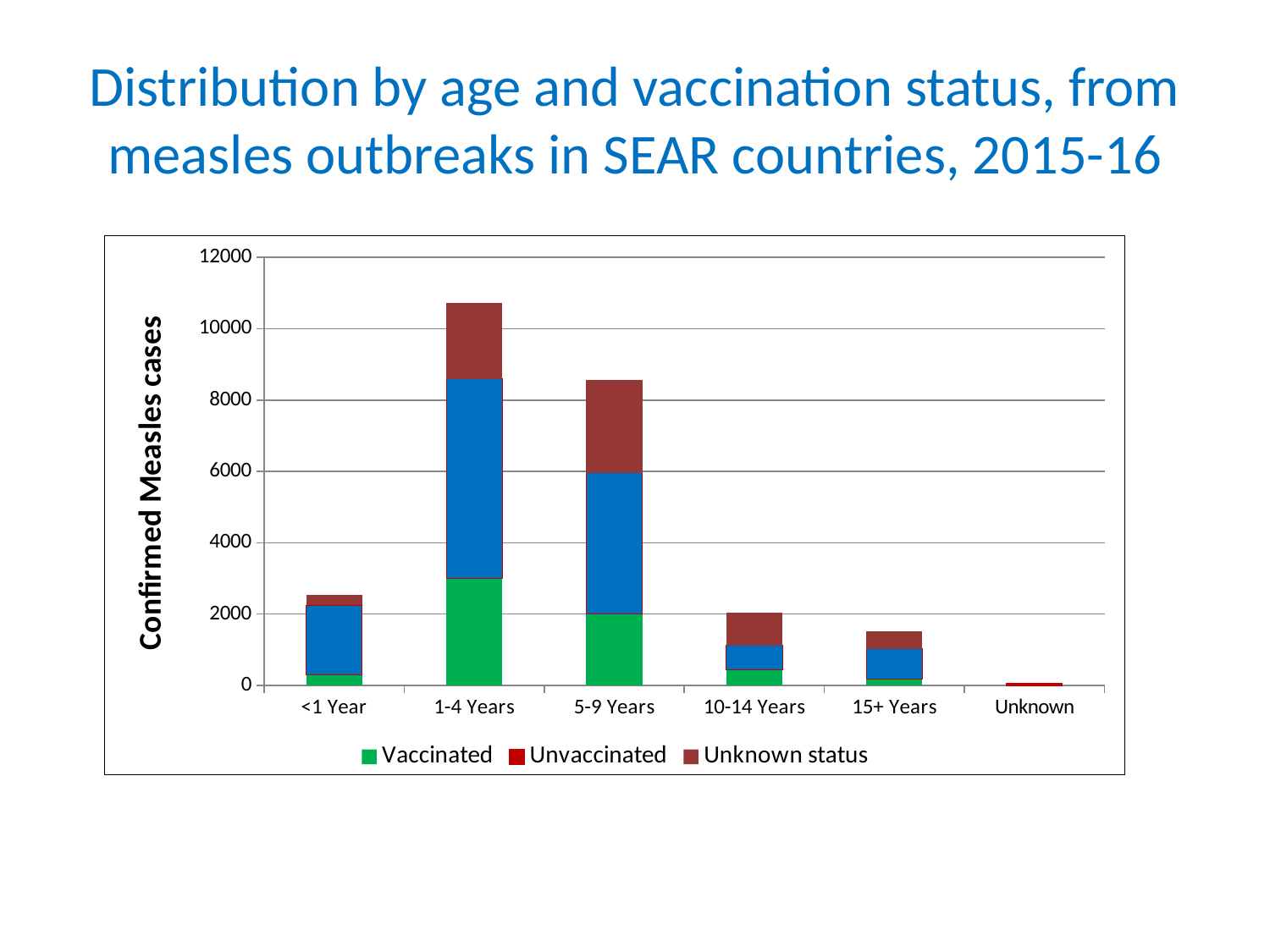
Which age group has more total confirmed measles cases, <1 Year or 15+ Years? <1 Year Is the total number of confirmed measles cases for 5-9 Years greater or less than 8000? greater Is the total number of confirmed measles cases for 15+ Years greater or less than 2000? less Is the total number of confirmed measles cases for 1-4 Years greater or less than 10000? greater Which age group has the highest total number of confirmed measles cases? 1-4 Years Which age group has more total confirmed measles cases, 1-4 Years or 5-9 Years? 1-4 Years How many age categories are shown on the x axis? 6 Do the total confirmed measles cases rise or fall across the age groups from 1-4 Years to 15+ Years? fall What is the label of the y axis? Confirmed Measles cases Which category has the lowest total number of confirmed measles cases? Unknown How many series does the legend list? 3 What kind of chart is shown on the slide? Stacked bar chart